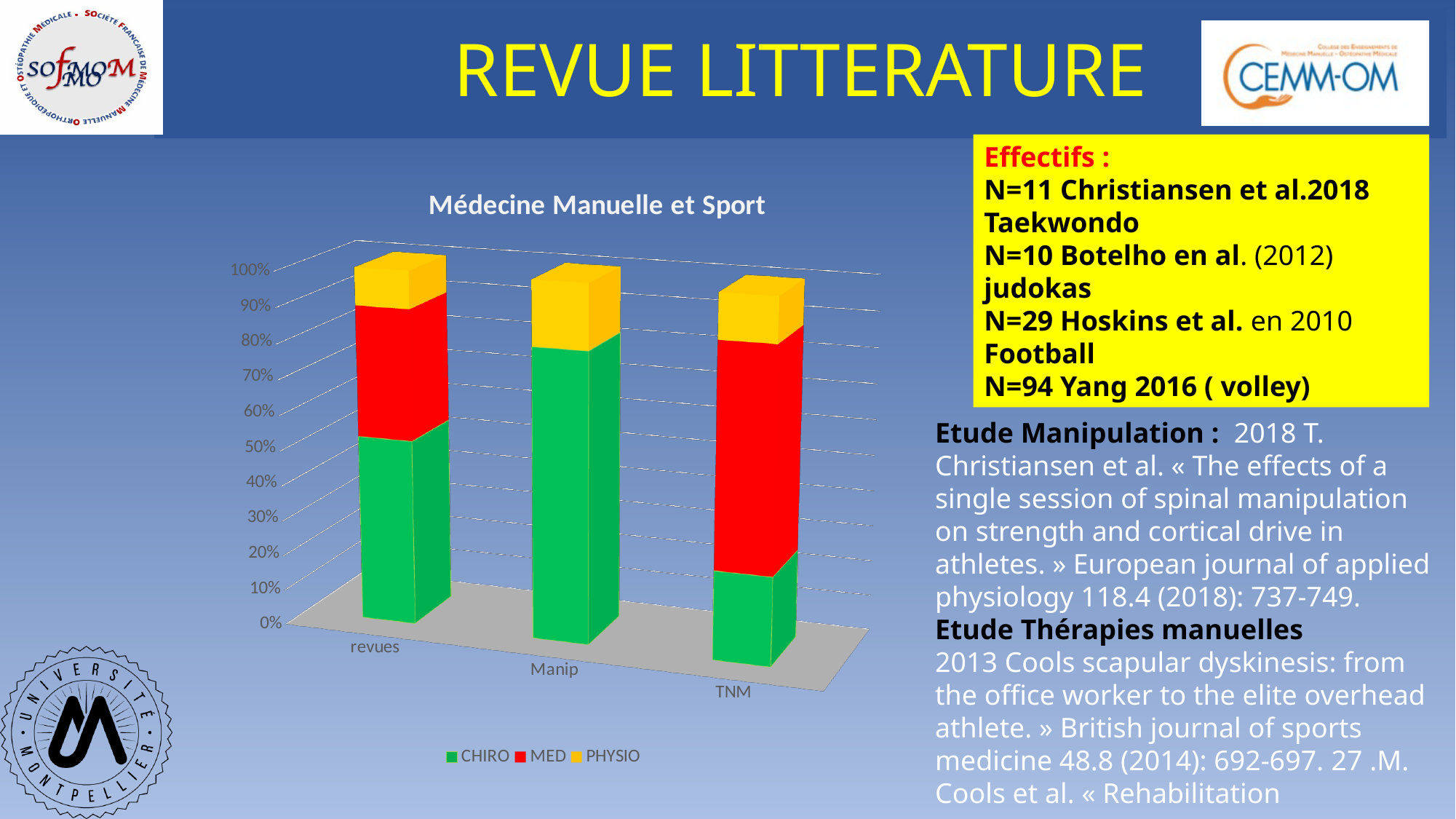
Is the CHIRO share for Manip greater or less than 70%? greater How many categories are shown on the x axis of the chart? 3 Which is larger, the CHIRO share for revues or the CHIRO share for TNM? revues Which category has the smallest CHIRO share? TNM Which category shows no MED segment in its bar? Manip What is the title of the chart? Médecine Manuelle et Sport How many series does the chart legend list? 3 Which category has the largest MED share? TNM Which series is shown in red in the chart? MED Is the CHIRO share for TNM greater or less than 30%? less What kind of chart is shown on the slide? bar chart Which category has the largest CHIRO share? Manip